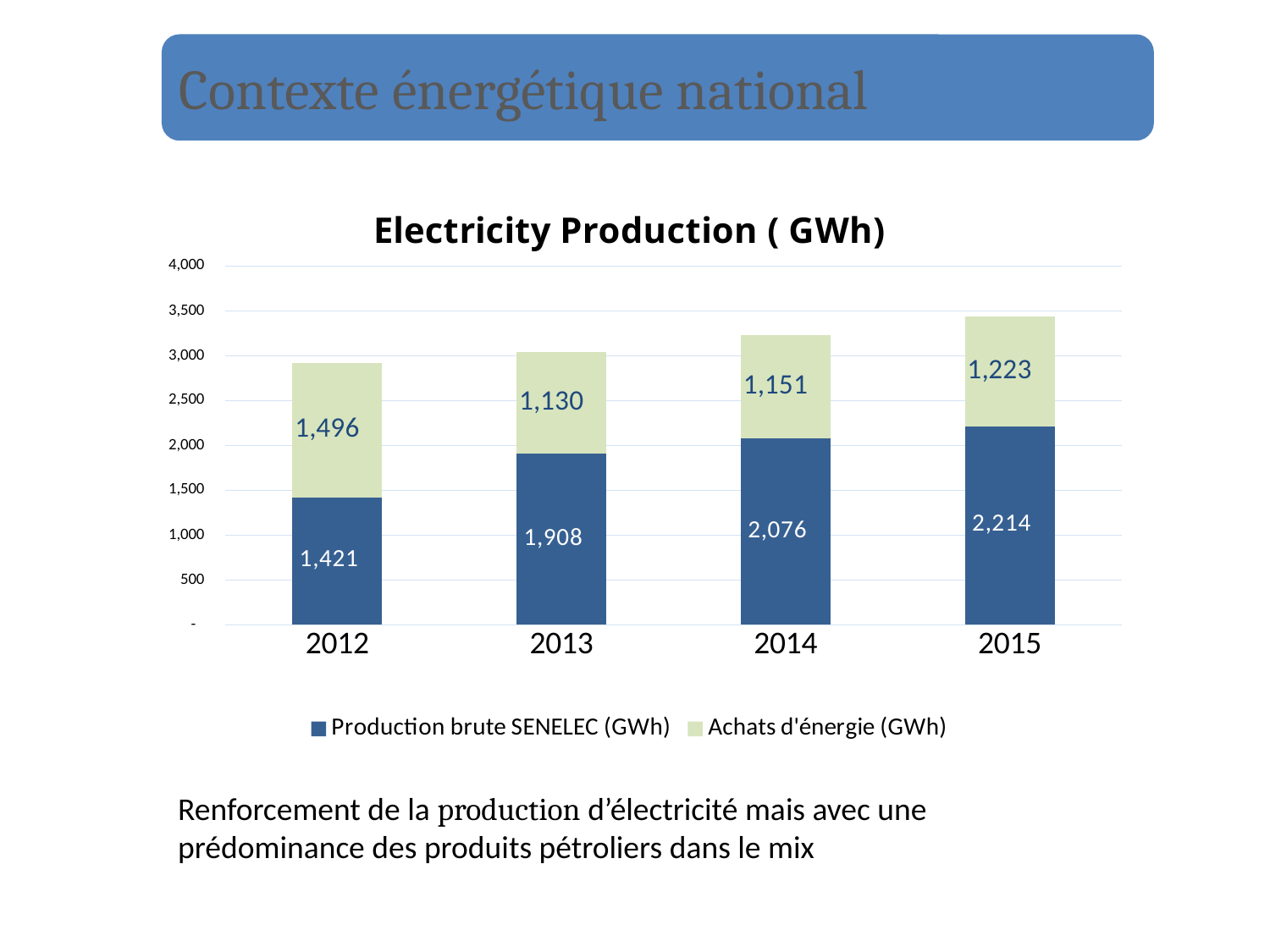
What kind of chart is shown on the slide? Stacked bar chart How many series does the legend list? 2 What is the value of Achats d'énergie (GWh) for 2012? 1,496 What is the value of Production brute SENELEC (GWh) for 2013? 1,908 How many years are shown on the x axis? 4 Which year has the highest value for Production brute SENELEC (GWh)? 2015 Which is larger in 2012: Production brute SENELEC (GWh) or Achats d'énergie (GWh)? Achats d'énergie (GWh) What is the difference between Production brute SENELEC (GWh) in 2015 and in 2012? 793 What is the value of Achats d'énergie (GWh) for 2015? 1,223 What is the total of the stacked bar for 2014? 3,227 Which year has the lowest value for Achats d'énergie (GWh)? 2013 Does Production brute SENELEC (GWh) rise or fall from 2012 to 2015? Rise